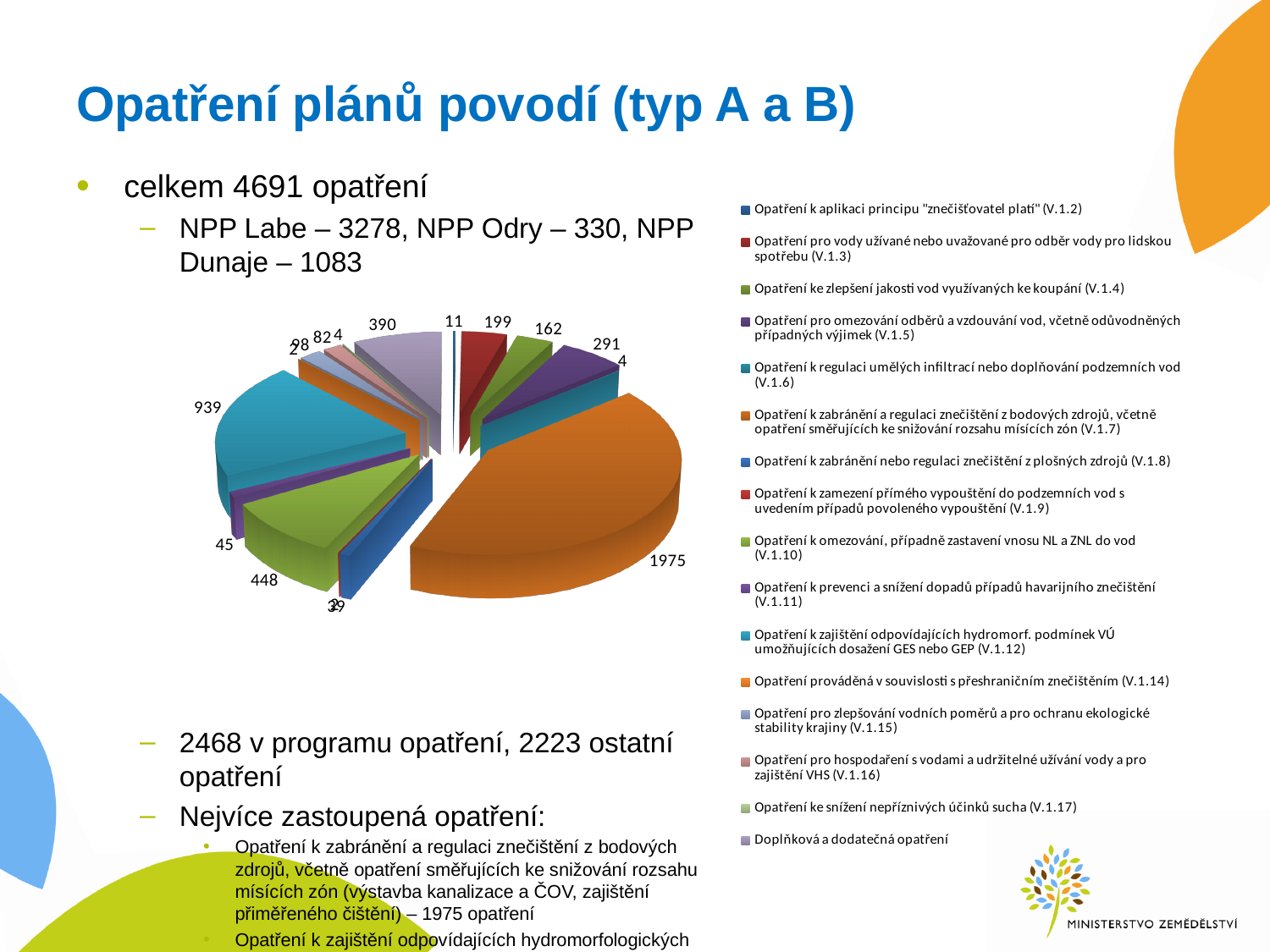
Which category has the largest slice in the pie chart? Opatření k zabránění a regulaci znečištění z bodových zdrojů, včetně opatření směřujících ke snižování rozsahu mísících zón (V.1.7) What colour is the largest slice of the pie chart? orange What is the value for Opatření k zajištění odpovídajících hydromorf. podmínek VÚ umožňujících dosažení GES nebo GEP (V.1.12)? 939 What kind of chart is shown on the slide? pie chart What is the value for Opatření k aplikaci principu "znečišťovatel platí" (V.1.2)? 11 What is the value for Opatření pro omezování odběrů a vzdouvání vod, včetně odůvodněných případných výjimek (V.1.5)? 291 What is the value of the largest slice in the pie chart? 1975 How many entries does the chart legend list? 16 Which is larger: the slice for V.1.7 or the slice for V.1.12? V.1.7 What is the value for Opatření ke zlepšení jakosti vod využívaných ke koupání (V.1.4)? 162 What is the difference between the largest slice (1975) and the slice for V.1.12 (939)? 1036 What is the value for Opatření pro vody užívané nebo uvažované pro odběr vody pro lidskou spotřebu (V.1.3)? 199